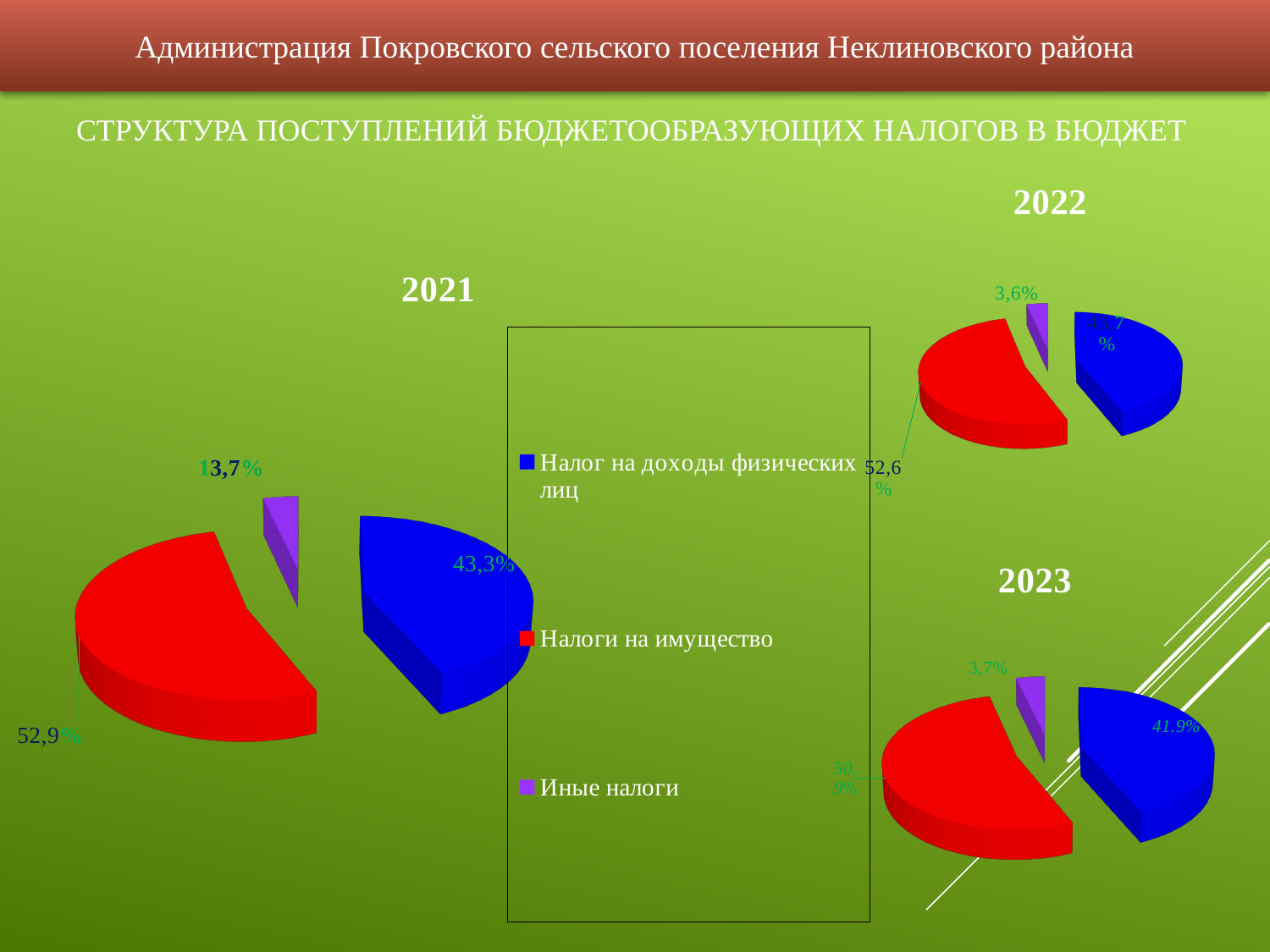
In the 2023 chart, what is the share for Налог на доходы физических лиц? 41.9% In the 2021 chart, what is the share for Налог на доходы физических лиц? 43,3% In the 2021 chart, what is the difference between the shares of Налоги на имущество and Налог на доходы физических лиц? 9,6% How many entries does the legend list? 3 In the 2021 chart, what is the share for Налоги на имущество? 52,9% In the 2022 chart, what is the share for Налоги на имущество? 52,6% What colour represents Иные налоги in the charts? Purple In the 2021 chart, which category has the smallest share? Иные налоги What kind of chart is used for the 2021 data? Pie chart In the 2022 chart, what is the share for Иные налоги? 3,6% In the 2023 chart, which is larger: Налоги на имущество or Налог на доходы физических лиц? Налоги на имущество In the 2021 chart, which category has the largest share? Налоги на имущество